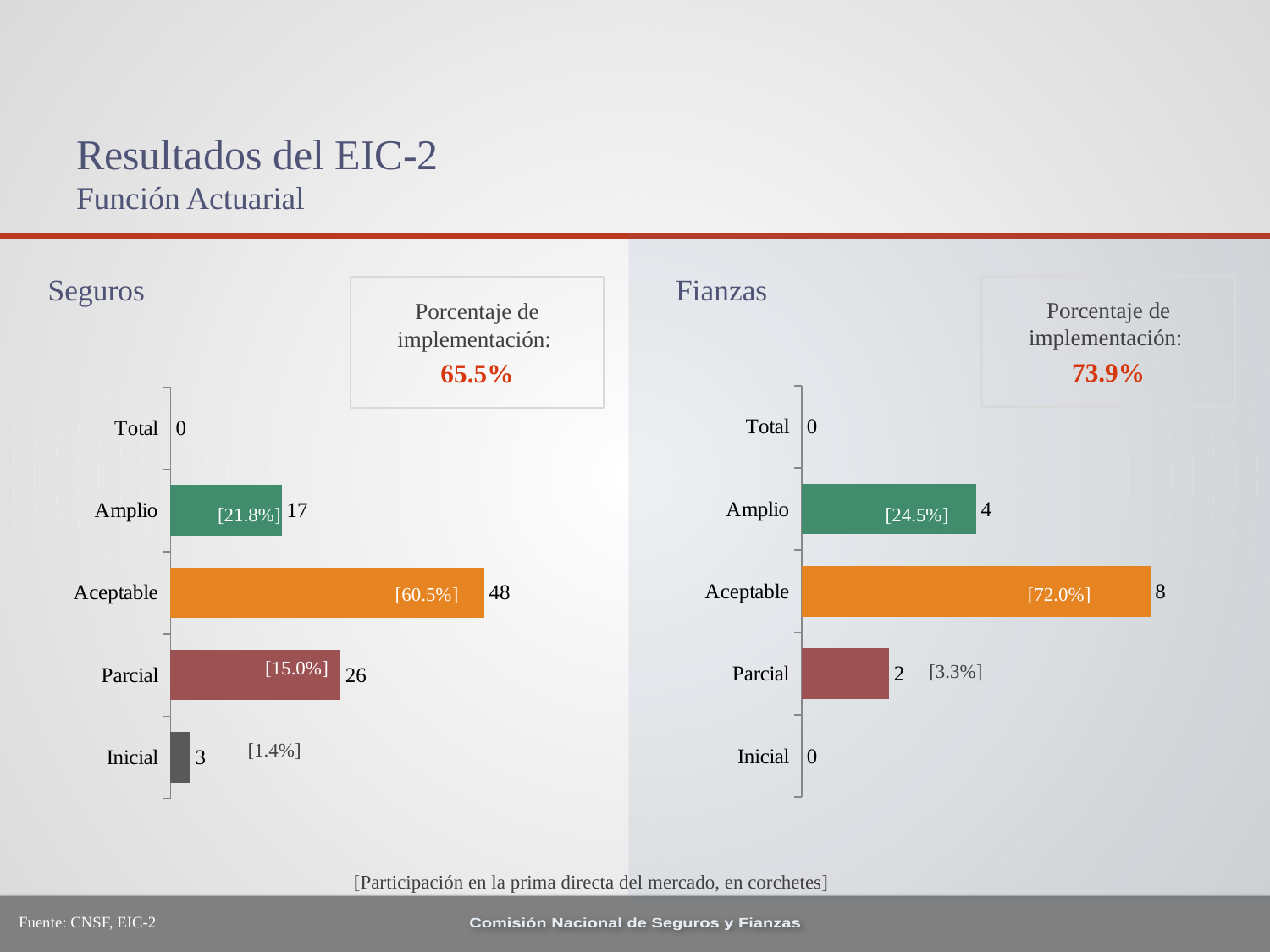
How many categories are shown in the Fianzas chart? 5 What is the Porcentaje de implementación shown for Fianzas? 73.9% In the Fianzas chart, what is the value for Amplio? 4 In the Seguros chart, which category has the highest value? Aceptable In the Fianzas chart, what is the bracketed percentage shown for Aceptable? [72.0%] In the Seguros chart, what is the bracketed percentage shown for Parcial? [15.0%] In the Seguros chart, what is the difference between the values for Aceptable and Parcial? 22 In the Fianzas chart, what is the difference between the values for Aceptable and Amplio? 4 In the Fianzas chart, which category has the highest value? Aceptable What kind of chart is the Seguros chart? Bar chart In the Seguros chart, what is the value for Aceptable? 48 In the Seguros chart, which is larger, the value for Amplio or the value for Parcial? Parcial